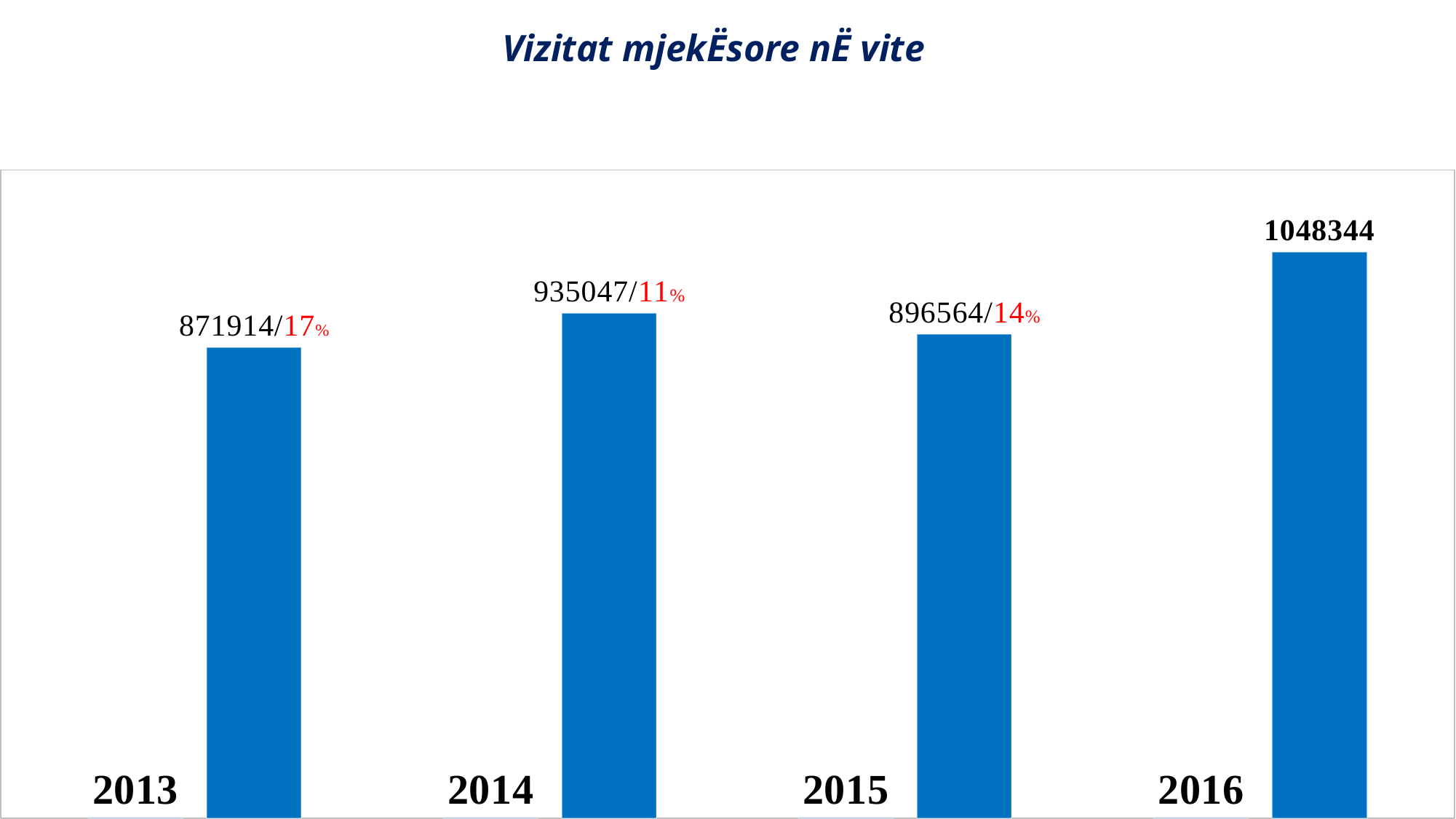
Which year has the lowest number of visits? 2013 Which year has the highest number of visits? 2016 Does the value rise or fall from 2014 to 2015? Fall What is the number of medical visits shown for 2016? 1048344 What is the number of medical visits shown for 2013? 871914 What is the difference between the 2014 value and the 2015 value? 38483 What is the difference between the 2016 value and the 2013 value? 176430 Which is larger, the value for 2014 or the value for 2015? 2014 What kind of chart is shown on the slide? Bar chart How many years are shown on the x axis? 4 What percentage is shown in red next to the 2015 value? 14% What percentage is shown in red next to the 2014 value? 11%